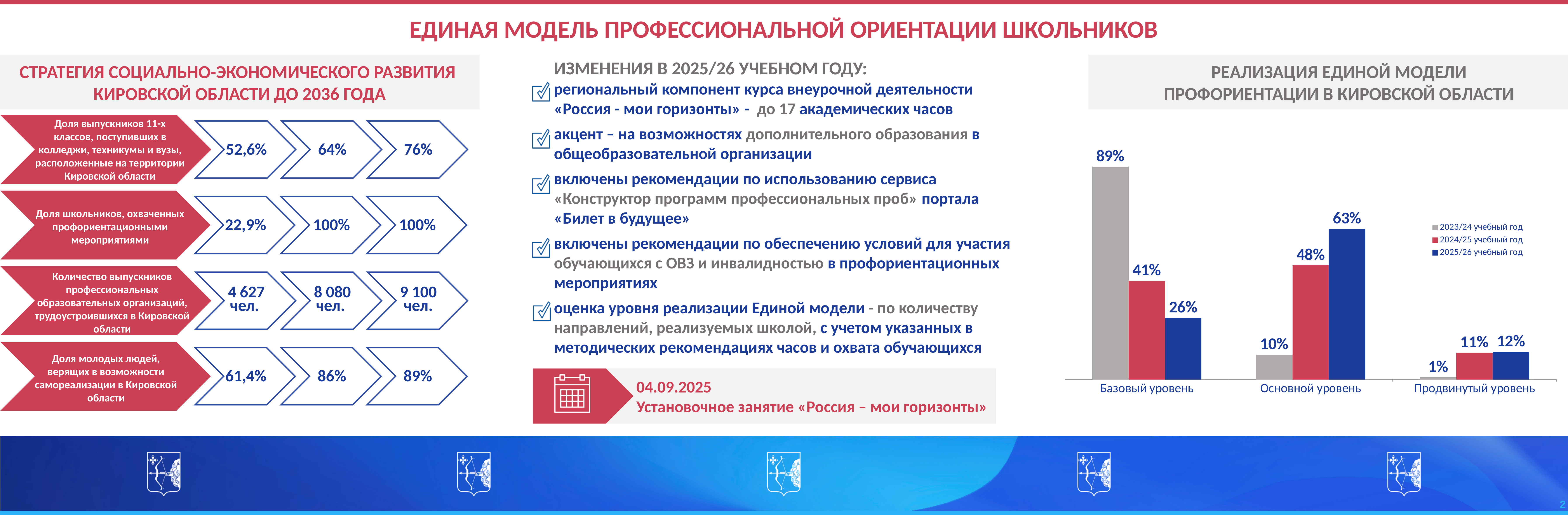
In the bar chart, what is the value for Основной уровень in the 2025/26 учебный год series? 63% In the bar chart, do the values for Основной уровень rise or fall from 2023/24 to 2025/26? rise How many series does the legend of the bar chart list? 3 In the bar chart, which is larger for Основной уровень: the 2024/25 value or the 2025/26 value? 2025/26 учебный год In the bar chart, which category has the highest value in the 2023/24 учебный год series? Базовый уровень In the bar chart, what is the value for Базовый уровень in the 2023/24 учебный год series? 89% What kind of chart is shown on the right side of the slide? bar chart In the bar chart, what is the difference between the 2023/24 and 2025/26 values for Базовый уровень? 63% In the bar chart, which category has the lowest value in the 2025/26 учебный год series? Продвинутый уровень In the bar chart, what is the value for Продвинутый уровень in the 2024/25 учебный год series? 11% How many categories are shown on the x axis of the bar chart? 3 What colour are the bars for the 2024/25 учебный год series in the bar chart? red